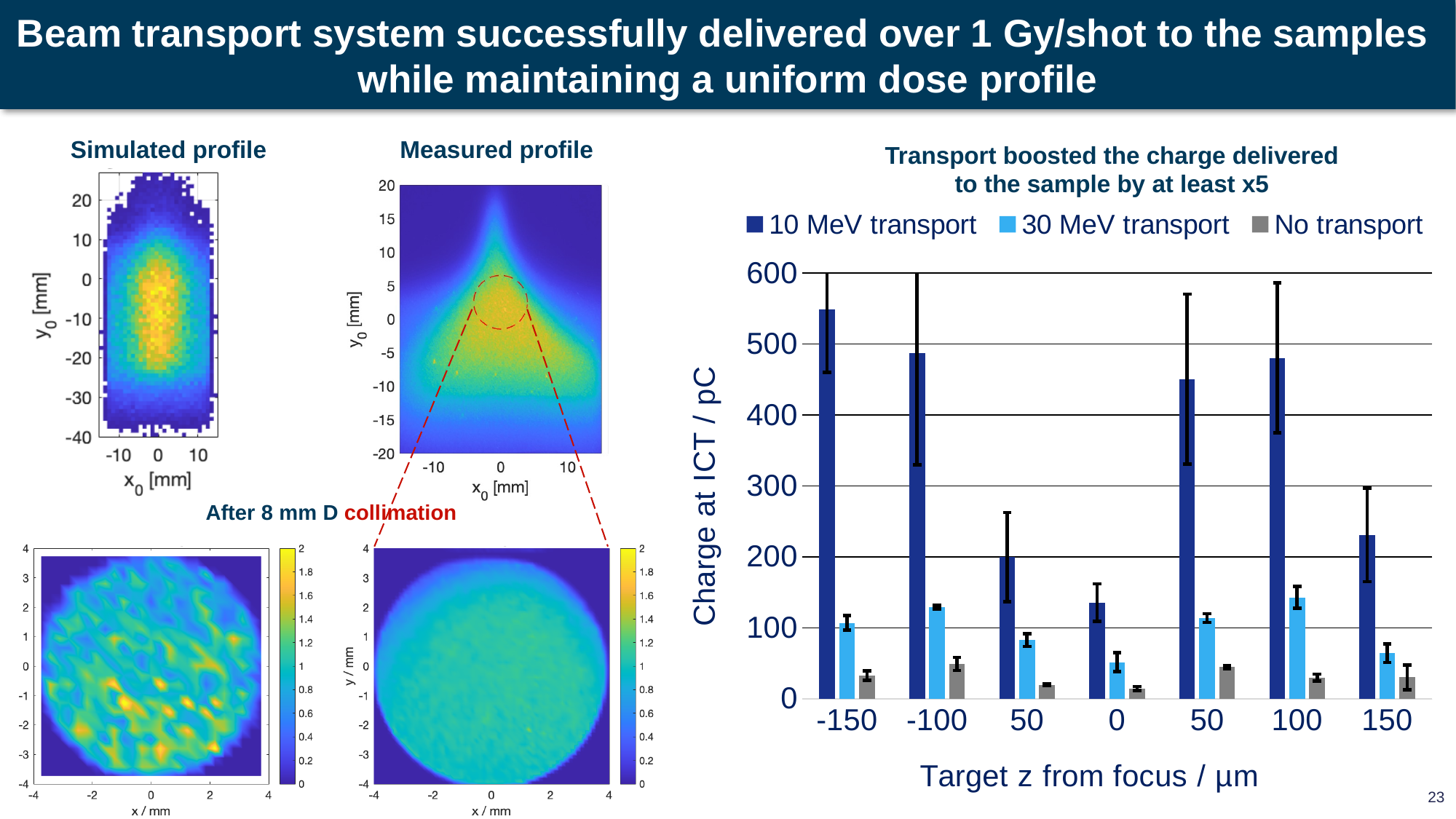
In the bar chart on the right, at which target z value is the 10 MeV transport charge lowest? 0 In the bar chart on the right, which series has the larger value at target z = -100: 30 MeV transport or No transport? 30 MeV transport In the bar chart on the right, at which target z value is the 10 MeV transport charge highest? -150 In the bar chart on the right, is the 10 MeV transport value at target z = 0 greater or less than 200? less In the bar chart on the right, is the 30 MeV transport value at target z = -100 greater or less than 100? greater In the bar chart on the right, how many series does the legend list? 3 What kind of chart is the chart on the right of the slide? bar chart In the bar chart on the right, how many target z categories are shown on the x axis? 7 In the bar chart on the right, is the No transport value at target z = -150 greater or less than 100? less What is the y-axis label of the bar chart on the right? Charge at ICT / pC In the bar chart on the right, which is larger: the 10 MeV transport value at target z = -150 or at target z = 150? -150